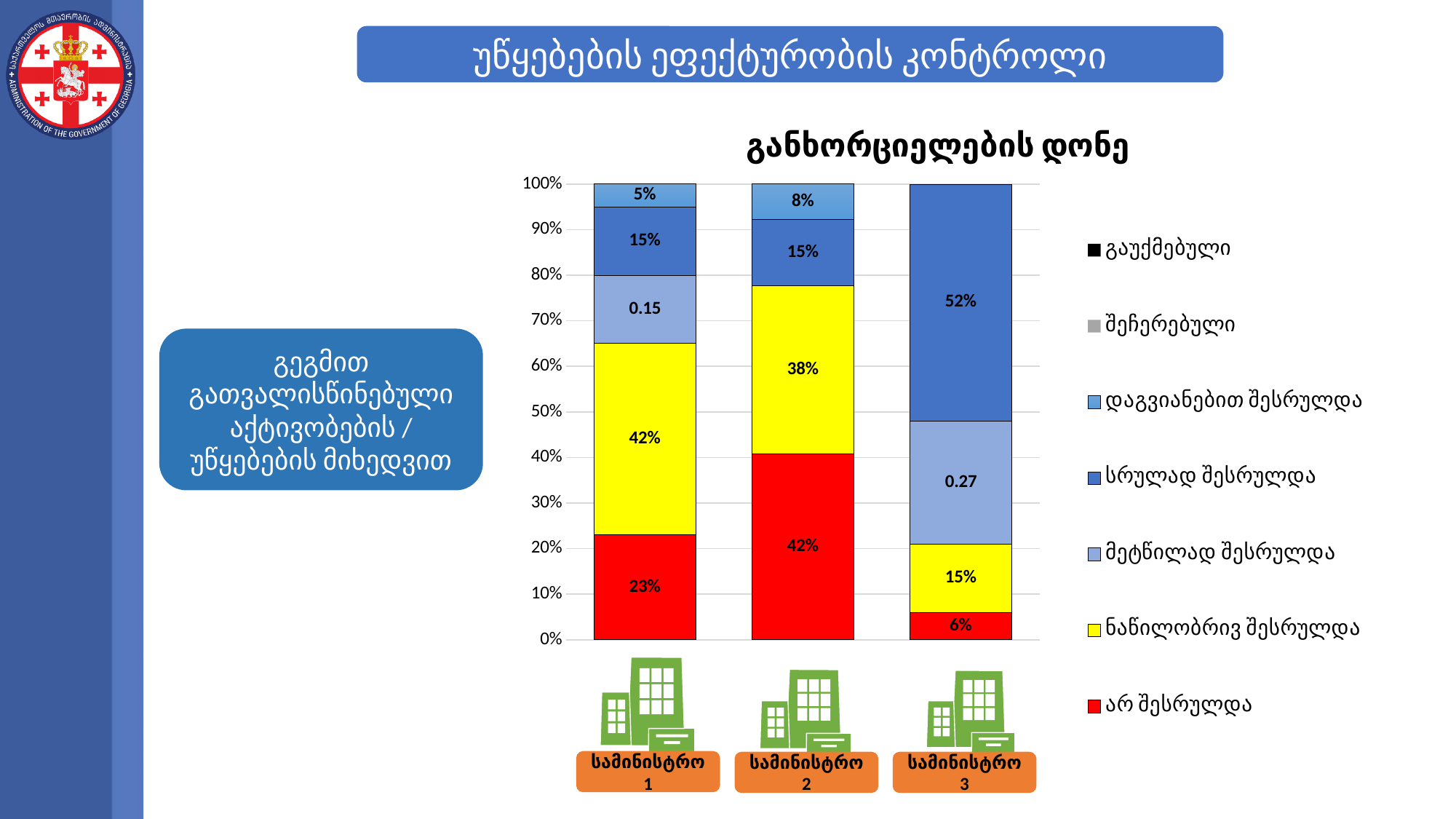
What is the value of სრულად შესრულდა for სამინისტრო 3? 52% What is the title of the chart? განხორციელების დონე How many series does the legend list? 7 What kind of chart is shown on the slide? stacked bar chart What is the value of ნაწილობრივ შესრულდა for სამინისტრო 1? 42% How many ministries (categories) are shown on the x axis? 3 Which ministry has the highest value for სრულად შესრულდა? სამინისტრო 3 What is the value of დაგვიანებით შესრულდა for სამინისტრო 2? 8% What is the difference between the არ შესრულდა values for სამინისტრო 2 and სამინისტრო 1? 19% What is the value of არ შესრულდა for სამინისტრო 2? 42% Which is larger: ნაწილობრივ შესრულდა for სამინისტრო 1 or for სამინისტრო 3? სამინისტრო 1 Which ministry has the lowest value for არ შესრულდა? სამინისტრო 3